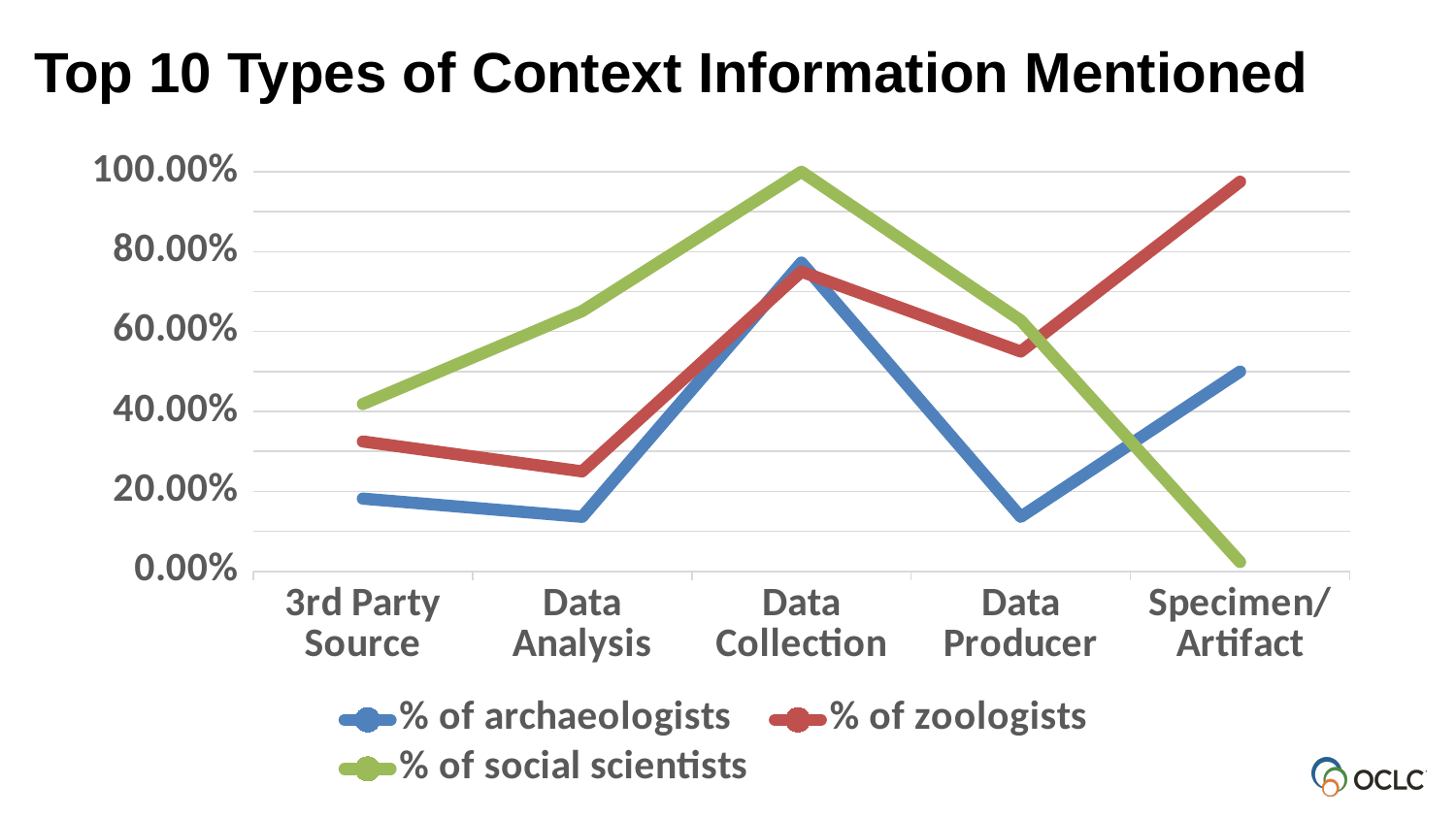
For which category is the % of zoologists highest? Specimen/Artifact What is the title of the chart? Top 10 Types of Context Information Mentioned For Specimen/Artifact, which is larger: the % of zoologists or the % of archaeologists? % of zoologists Is the % of zoologists for Specimen/Artifact greater or less than 80.00%? greater What is the % of social scientists for Data Collection? 100.00% For which category is the % of social scientists lowest? Specimen/Artifact Is the % of archaeologists for Data Producer greater or less than 20.00%? less How many series does the legend list? 3 For which category is the % of social scientists highest? Data Collection How many categories are shown on the x axis? 5 For which category is the % of archaeologists highest? Data Collection What kind of chart is shown on the slide? line chart